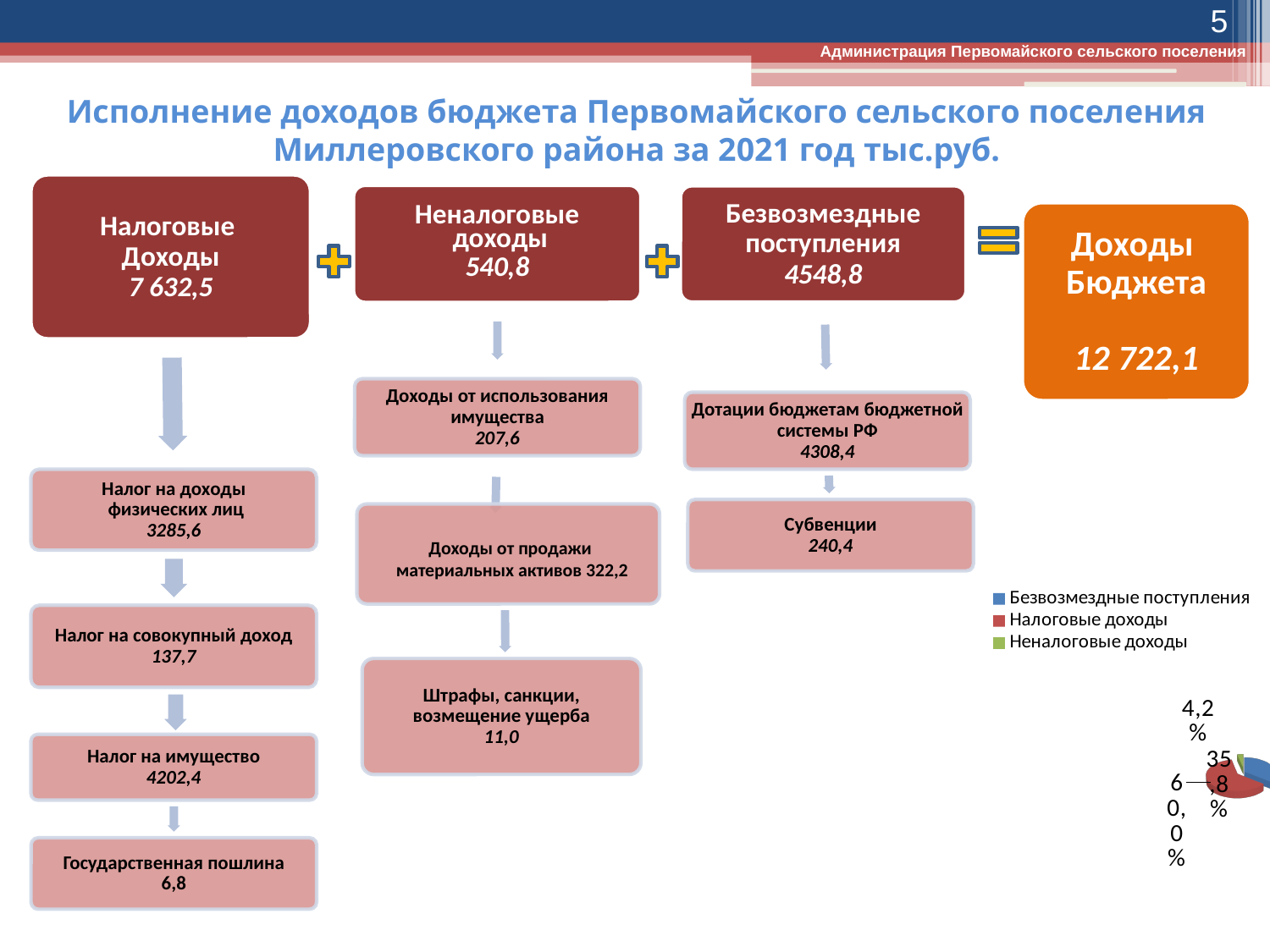
Which category does the pie chart's legend show in blue? Безвозмездные поступления Which category does the pie chart's legend show in red? Налоговые доходы How many slices does the pie chart have? 3 What percentage label is shown for the largest slice of the pie chart? 60,0% Which category has the largest slice in the pie chart? Налоговые доходы In the pie chart, is the slice for Налоговые доходы larger or smaller than the slice for Безвозмездные поступления? larger Which category has the smallest slice in the pie chart? Неналоговые доходы What percentage label is shown for the smallest slice of the pie chart? 4,2% How many entries does the legend of the pie chart list? 3 What kind of chart is shown in the bottom-right corner of the slide? pie chart